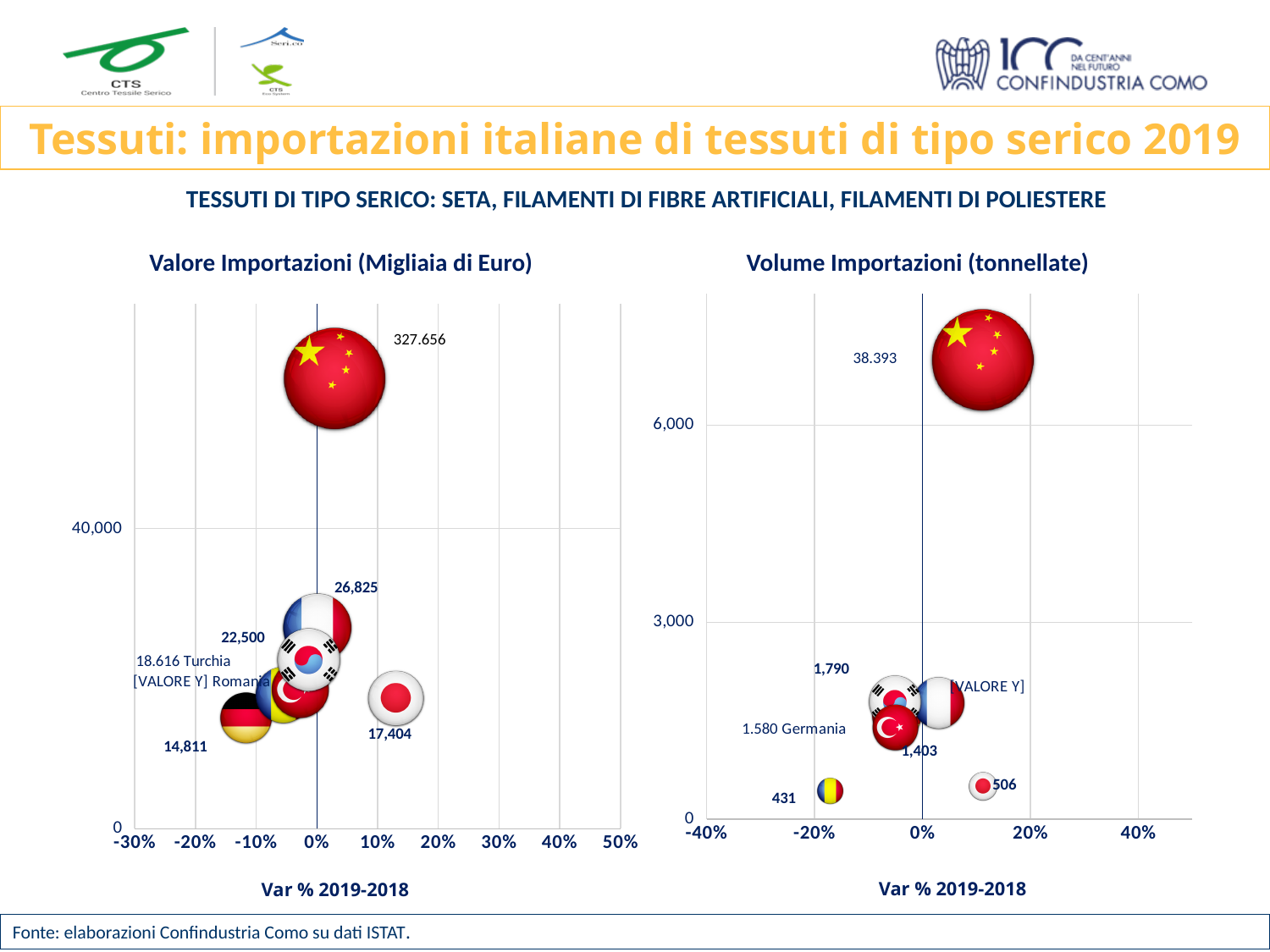
How many bubbles are plotted on the left chart 'Valore Importazioni (Migliaia di Euro)'? 7 On the right chart 'Volume Importazioni (tonnellate)', what value is labeled for Germania? 1.580 On the right chart 'Volume Importazioni (tonnellate)', what is the highest value labeled? 38.393 On the left chart 'Valore Importazioni (Migliaia di Euro)', what is the lowest numeric value labeled? 14,811 On the right chart 'Volume Importazioni (tonnellate)', is the value for Germania greater or less than 3,000? less On the left chart 'Valore Importazioni (Migliaia di Euro)', what value is labeled for Turchia? 18.616 On the left chart 'Valore Importazioni (Migliaia di Euro)', what is the highest value labeled? 327.656 What kind of chart is the left chart, 'Valore Importazioni (Migliaia di Euro)'? bubble chart On the right chart 'Volume Importazioni (tonnellate)', what is the lowest value labeled? 431 What is the x-axis title of the right chart 'Volume Importazioni (tonnellate)'? Var % 2019-2018 On the left chart 'Valore Importazioni (Migliaia di Euro)', is the value for Turchia greater or less than 40,000? less